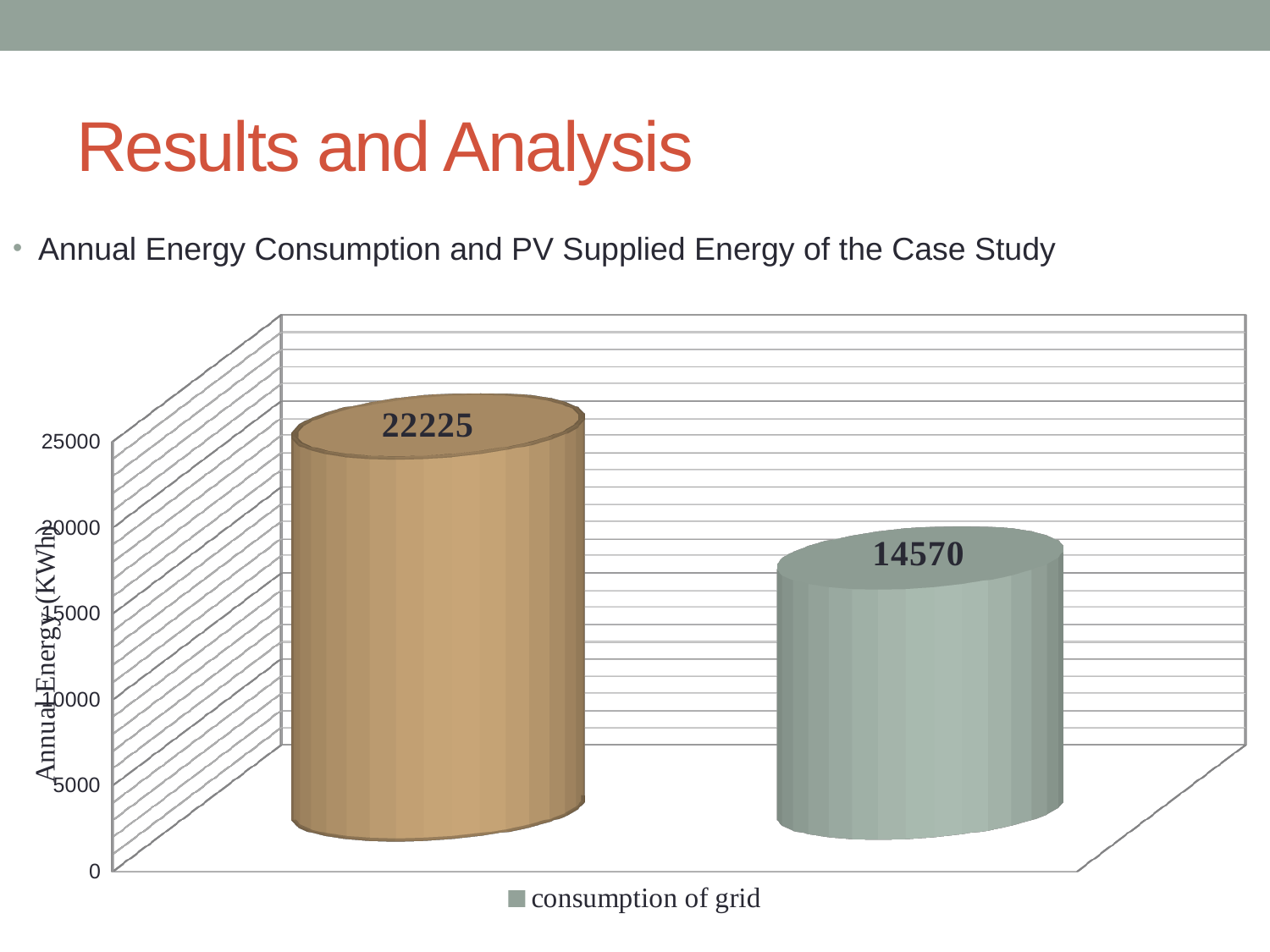
What is the difference between the values of the left bar and the right bar? 7655 Which bar has the lower value, the left one or the right one? the right one What kind of chart is shown on the slide? bar chart What is the title of the vertical axis? Annual Energy (KWh) How many bars are plotted in the chart? 2 What entry is shown in the chart legend? consumption of grid Is the value of the left bar larger or smaller than the value of the right bar? larger What value is labelled on the left (tan) bar? 22225 What is the highest tick value shown on the vertical axis? 25000 What value is labelled on the right (green-grey) bar? 14570 How many entries does the chart legend list? 1 Which bar has the higher value, the left one or the right one? the left one